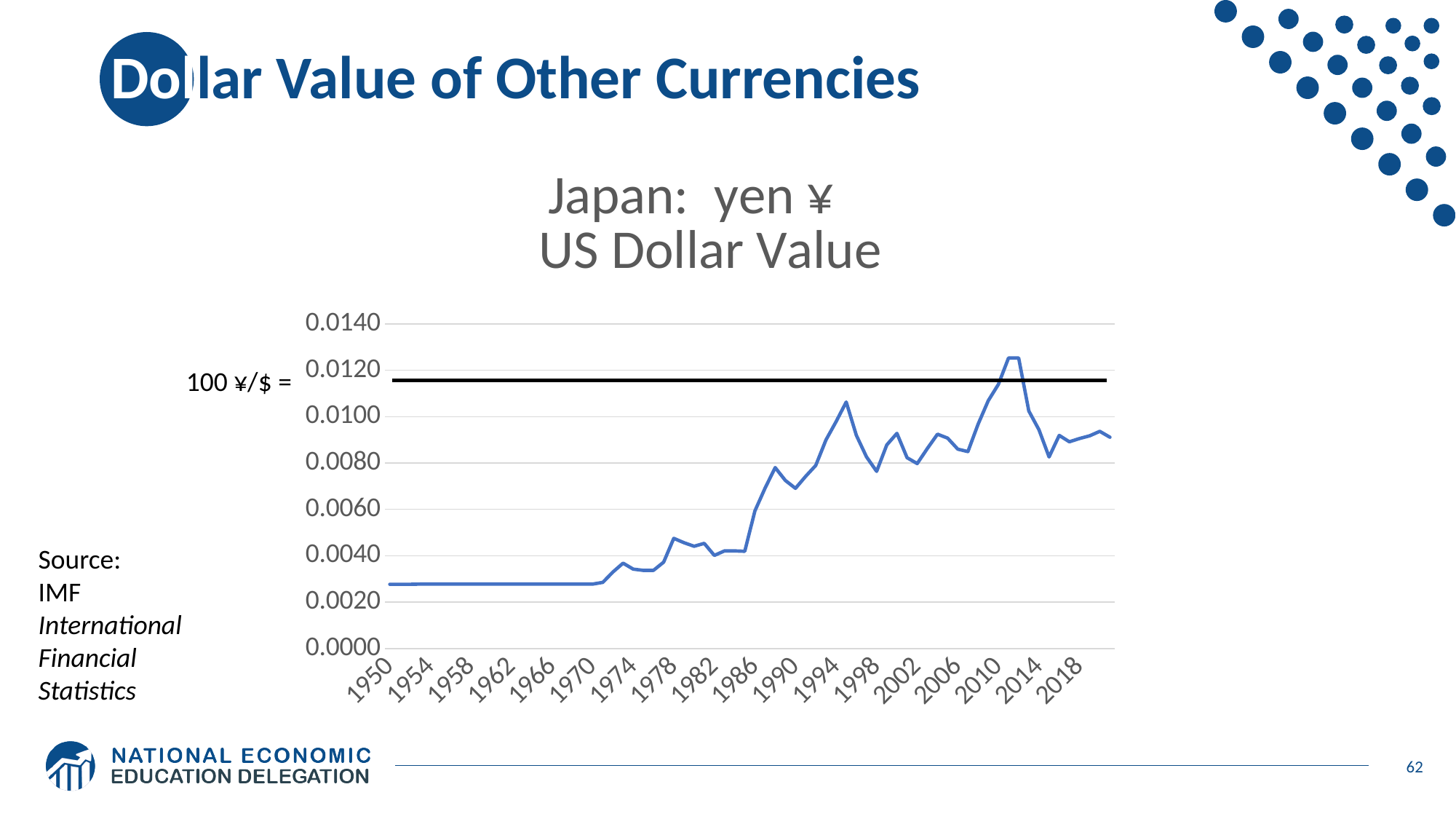
Is the value for 2018 greater or less than 0.0080? greater What kind of chart is shown on the slide? line chart Is the value for 1990 greater or less than 0.0060? greater Which year has the larger value, 1994 or 1998? 1994 Is the value for 1970 greater or less than 0.0040? less How many year labels are shown on the x axis? 18 Which year has the larger value, 1986 or 1990? 1990 Overall, does the US dollar value of the yen rise or fall from 1950 to 2018? rise What is the title of the chart? Japan: yen ¥ US Dollar Value What label is attached to the horizontal black reference line on the chart? 100 ¥/$ =